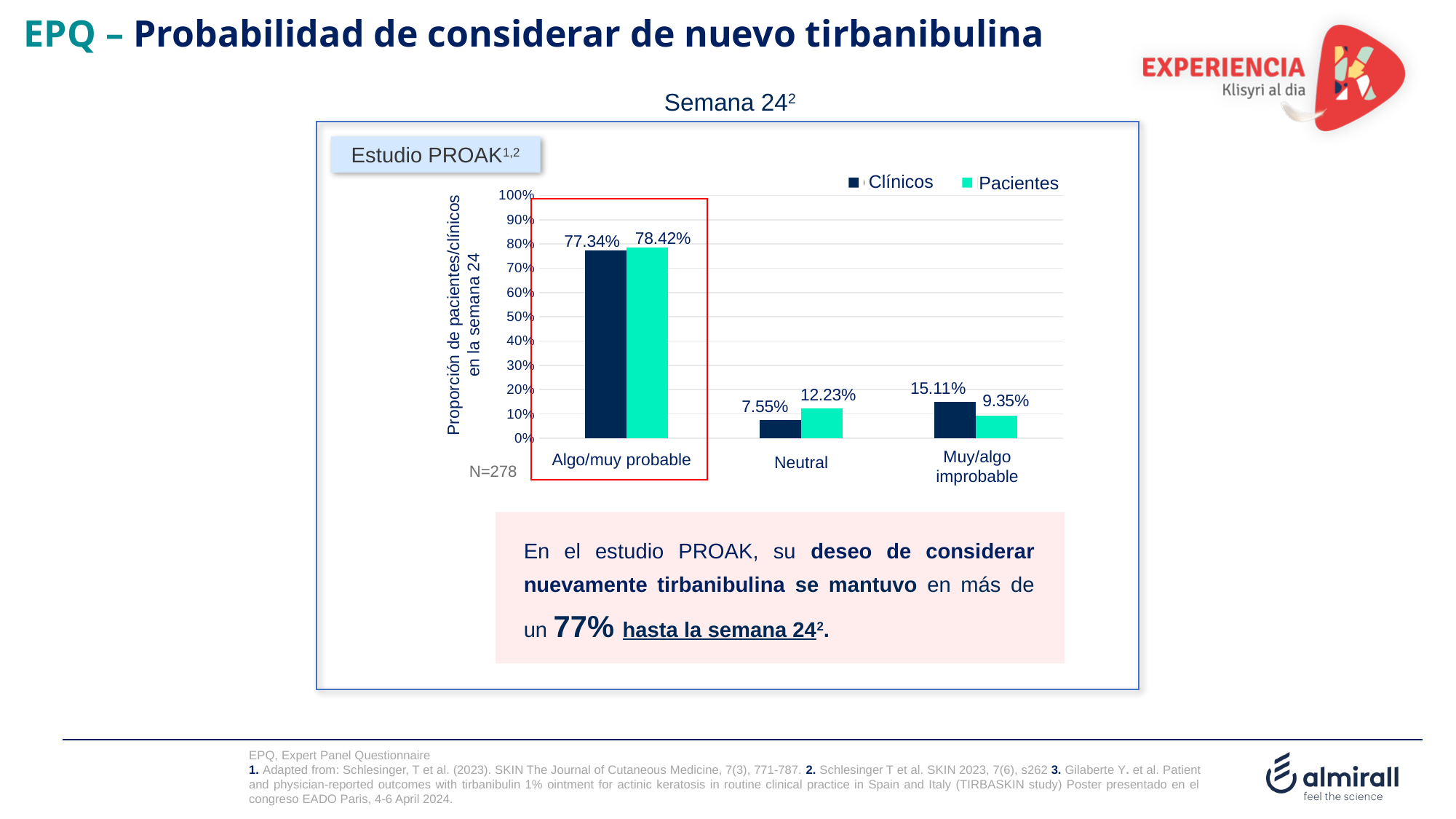
What is the value for Pacientes in the Algo/muy probable category? 78.42% Which category has the lowest value for Pacientes? Muy/algo improbable Which category has the highest value for Clínicos? Algo/muy probable How many categories are shown on the x axis? 3 How many series does the legend list? 2 What is the value for Clínicos in the Algo/muy probable category? 77.34% What is the value for Clínicos in the Neutral category? 7.55% What is the difference between the Pacientes and Clínicos values in the Neutral category? 4.68% In the Muy/algo improbable category, which series has the larger value, Clínicos or Pacientes? Clínicos What is the value for Pacientes in the Muy/algo improbable category? 9.35% Is the value for Clínicos in the Muy/algo improbable category greater or less than 20%? less What kind of chart is shown on the slide? bar chart